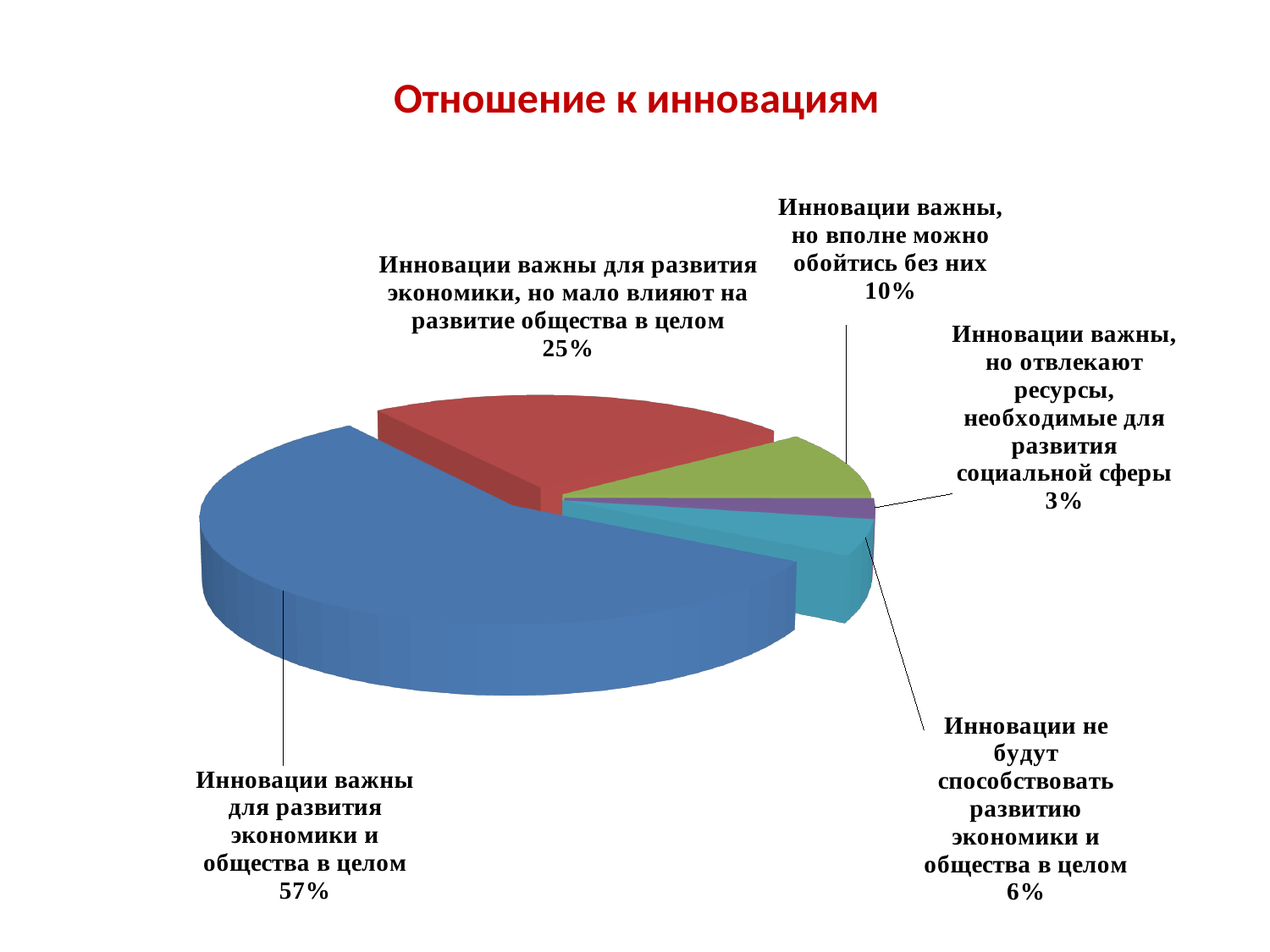
Какова доля ответа «Инновации не будут способствовать развитию экономики и общества в целом»? 6% Какова доля ответа «Инновации важны для развития экономики и общества в целом»? 57% Какой вариант ответа имеет наибольшую долю? Инновации важны для развития экономики и общества в целом Какова доля ответа «Инновации важны для развития экономики, но мало влияют на развитие общества в целом»? 25% Как называется диаграмма на слайде? Отношение к инновациям Что больше: доля ответа «Инновации важны, но вполне можно обойтись без них» или доля ответа «Инновации не будут способствовать развитию экономики и общества в целом»? Инновации важны, но вполне можно обойтись без них Какой тип диаграммы показан на слайде? Круговая диаграмма Сколько секторов на круговой диаграмме? 5 На сколько процентных пунктов доля ответа «Инновации важны для развития экономики и общества в целом» больше доли ответа «Инновации важны для развития экономики, но мало влияют на развитие общества в целом»? 32 Какова доля ответа «Инновации важны, но отвлекают ресурсы, необходимые для развития социальной сферы»? 3% Какой вариант ответа имеет наименьшую долю? Инновации важны, но отвлекают ресурсы, необходимые для развития социальной сферы Какова доля ответа «Инновации важны, но вполне можно обойтись без них»? 10%